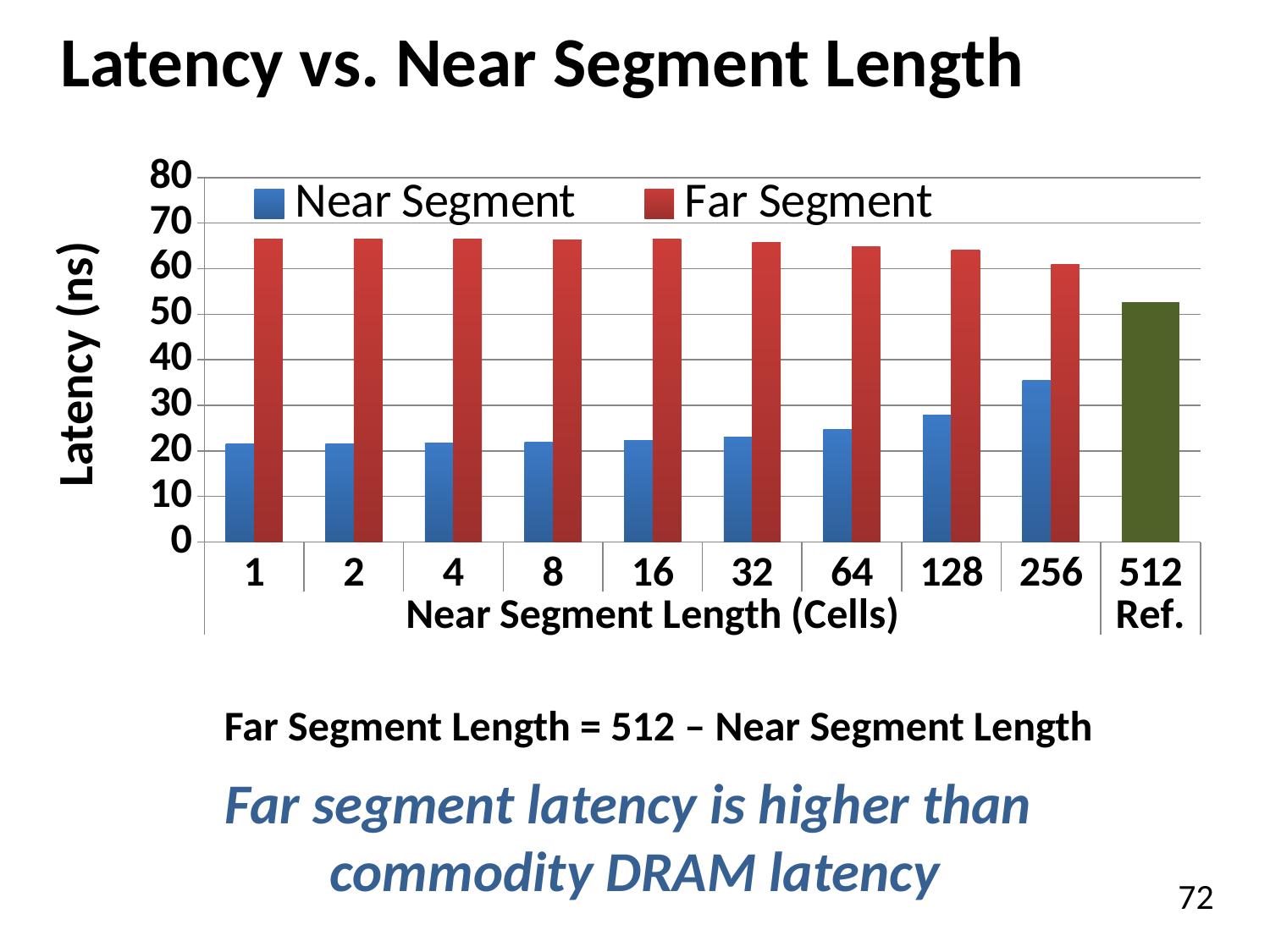
Is the Far Segment latency for near segment length 1 greater or less than 70? less Is the latency for 512 Ref. greater or less than 40? greater Which near segment length has the lowest Far Segment latency? 256 How many series does the legend list? 2 What is the label of the y axis? Latency (ns) Which is larger at near segment length 128: the Near Segment latency or the Far Segment latency? Far Segment How many categories are shown along the x axis? 10 What kind of chart is shown on the slide? bar chart Does the Near Segment latency rise or fall as the near segment length increases along the x axis? rise Is the Near Segment latency for near segment length 1 greater or less than 30? less Which near segment length has the highest Near Segment latency? 256